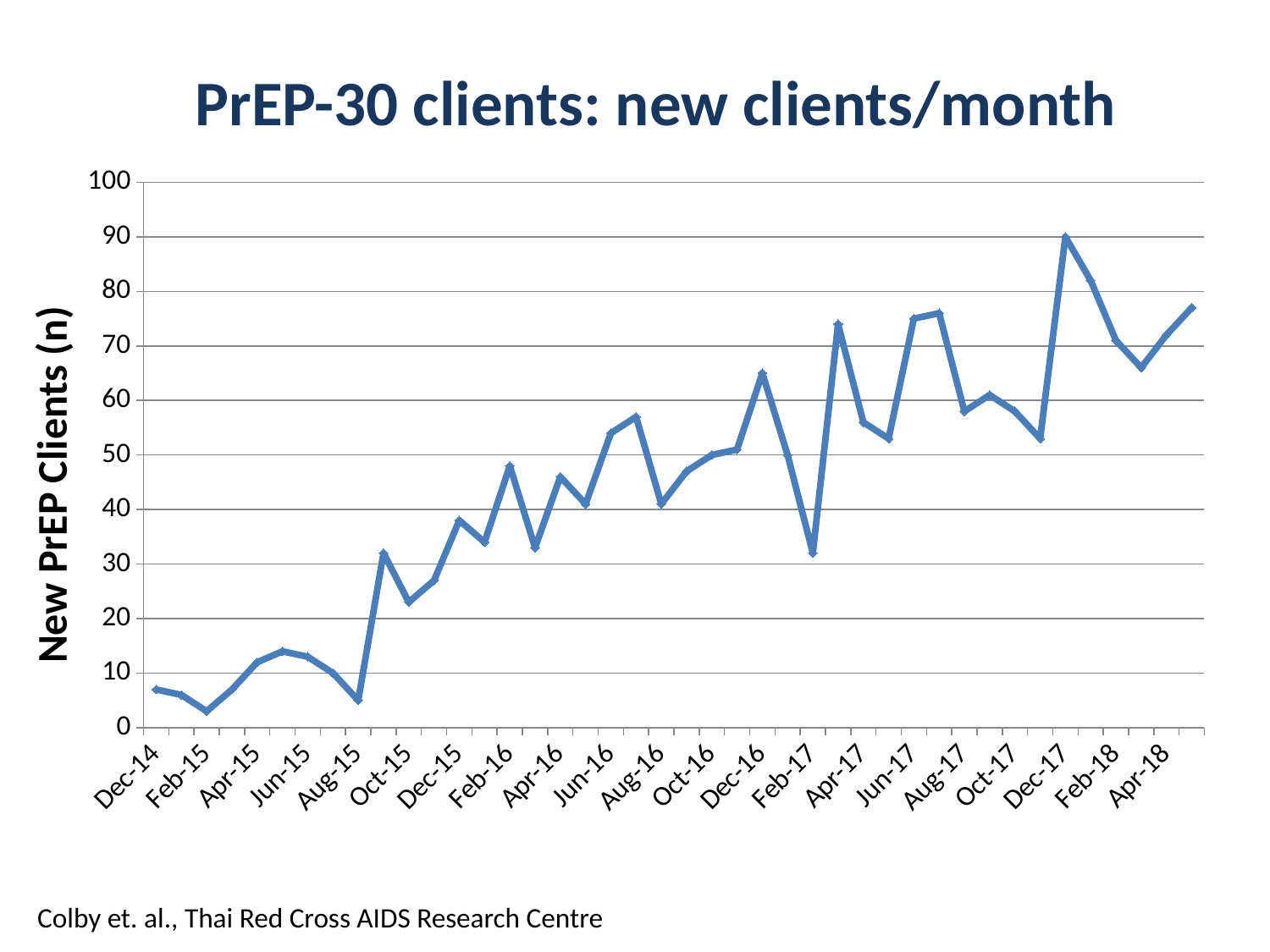
Is the value for Dec-14 greater or less than 10? less Which month has the lowest number of new PrEP clients? Feb-15 What is the title of the chart? PrEP-30 clients: new clients/month Overall, do the values rise or fall from Dec-14 to the end of the series? rise Is the value for Feb-17 greater or less than 40? less What kind of chart is shown on the slide? line chart Which month has the highest number of new PrEP clients? Dec-17 Is the value for Dec-17 greater or less than 80? greater Which month has the larger value, Dec-17 or Feb-18? Dec-17 Which month has the larger value, Dec-16 or Feb-17? Dec-16 What is the label on the vertical axis of the chart? New PrEP Clients (n)